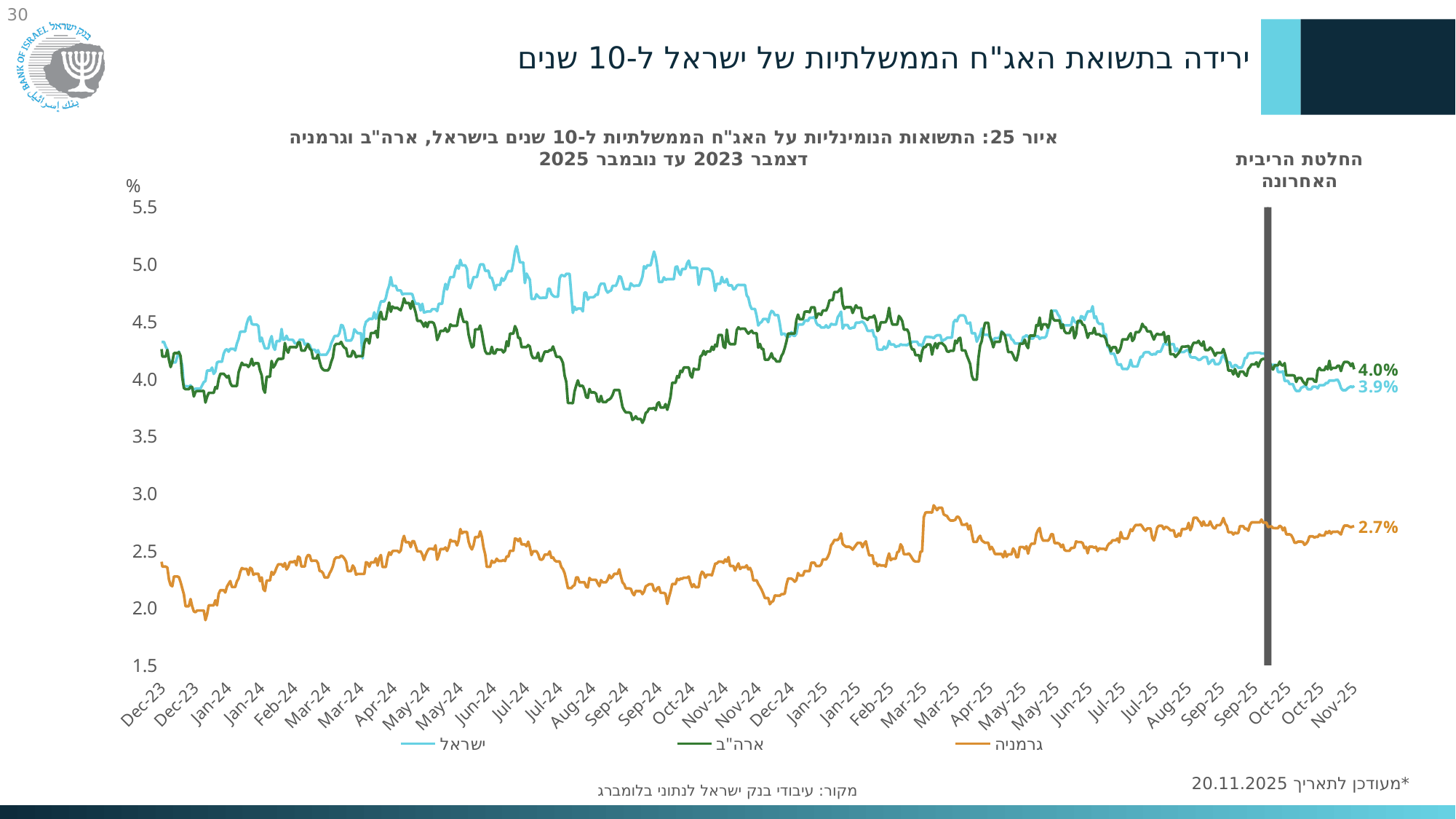
What is the difference between the latest labelled values for the US and Israel? 0.1% Does the Israel line rise or fall from its peak around Jul-24 to Nov-25? fall What does the vertical grey line near Oct-25 mark, according to its label? החלטת הריבית האחרונה What kind of chart is shown on the slide? line chart Which series has the lowest value at the right end of the chart? Germany (גרמניה) Is the value for Israel around Jul-24 greater or less than 4.5? greater What is the latest value labelled for the US (ארה"ב) at the right end of the chart? 4.0% What is the difference between the latest labelled values for the US and Germany? 1.3% At the right end of the chart, which is higher: the Israel line or the Germany line? Israel What is the latest value labelled for Germany (גרמניה) at the right end of the chart? 2.7% What is the latest value labelled for Israel (ישראל) at the right end of the chart? 3.9% How many series does the legend list? 3